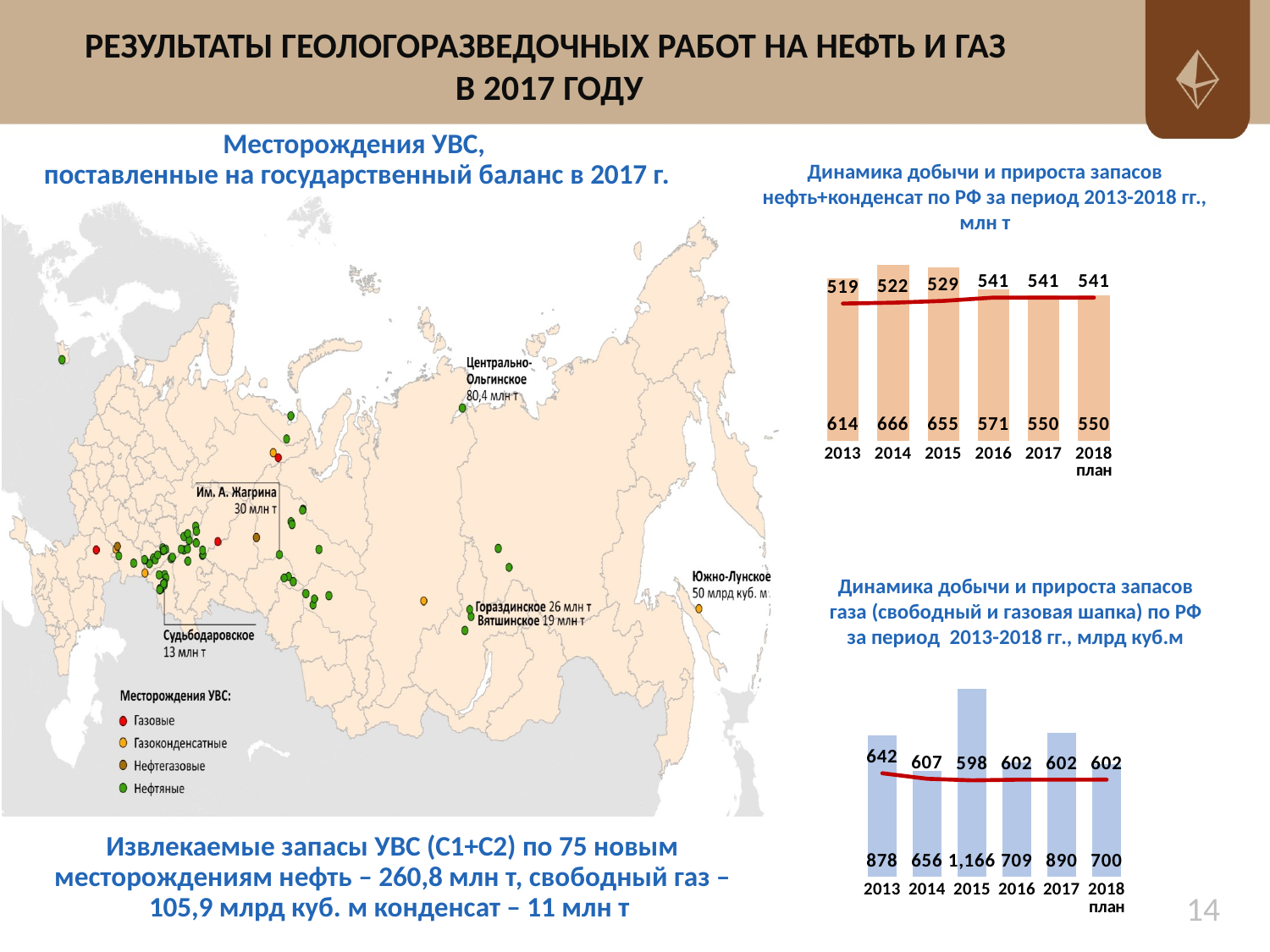
In the bottom-right chart (gas, 2013-2018), what value is printed at the bottom of the bar for 2015? 1,166 How many years are shown on the x axis of the top-right chart (oil+condensate)? 6 In the top-right chart (oil+condensate, 2013-2018), what value is printed at the bottom of the bar for 2014? 666 In the top-right chart (oil+condensate), what value is printed on the line for 2016? 541 What type of chart is the bottom-right chart (gas, 2013-2018)? bar chart with a line In the bottom-right chart (gas), which year has the lowest bar value? 2014 In the top-right chart (oil+condensate), which year has the highest bar value? 2014 In the bottom-right chart (gas), what value is printed on the line for 2013? 642 In the bottom-right chart (gas), what is the difference between the bar values for 2015 and 2016? 457 In the bottom-right chart (gas), which is larger, the bar value for 2013 or for 2017? 2017 In the top-right chart (oil+condensate), do the line values rise or fall from 2013 to 2016? rise In the top-right chart (oil+condensate), what is the difference between the bar values for 2013 and 2017? 64